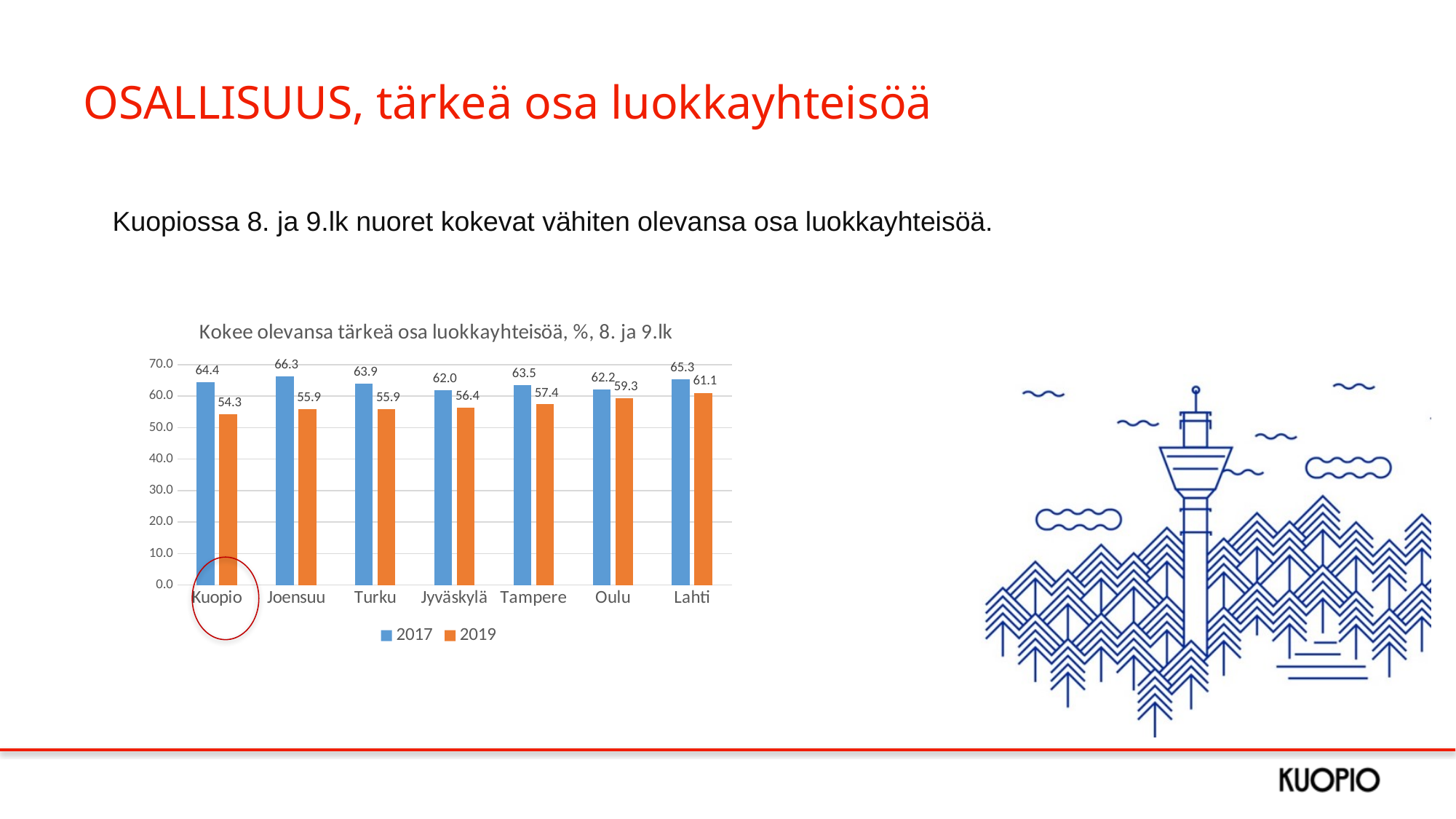
How many series does the legend list? 2 Which city has the lowest 2019 value? Kuopio Which city has the highest 2019 value? Lahti What is the 2019 value for Kuopio? 54.3 How many cities are shown on the x axis? 7 What is the difference between the 2017 and 2019 values for Kuopio? 10.1 Which city has the highest 2017 value? Joensuu What is the 2019 value for Lahti? 61.1 What is the 2017 value for Joensuu? 66.3 Which is larger, the 2019 value for Tampere or the 2019 value for Turku? Tampere What is the 2017 value for Oulu? 62.2 What type of chart is shown? Bar chart